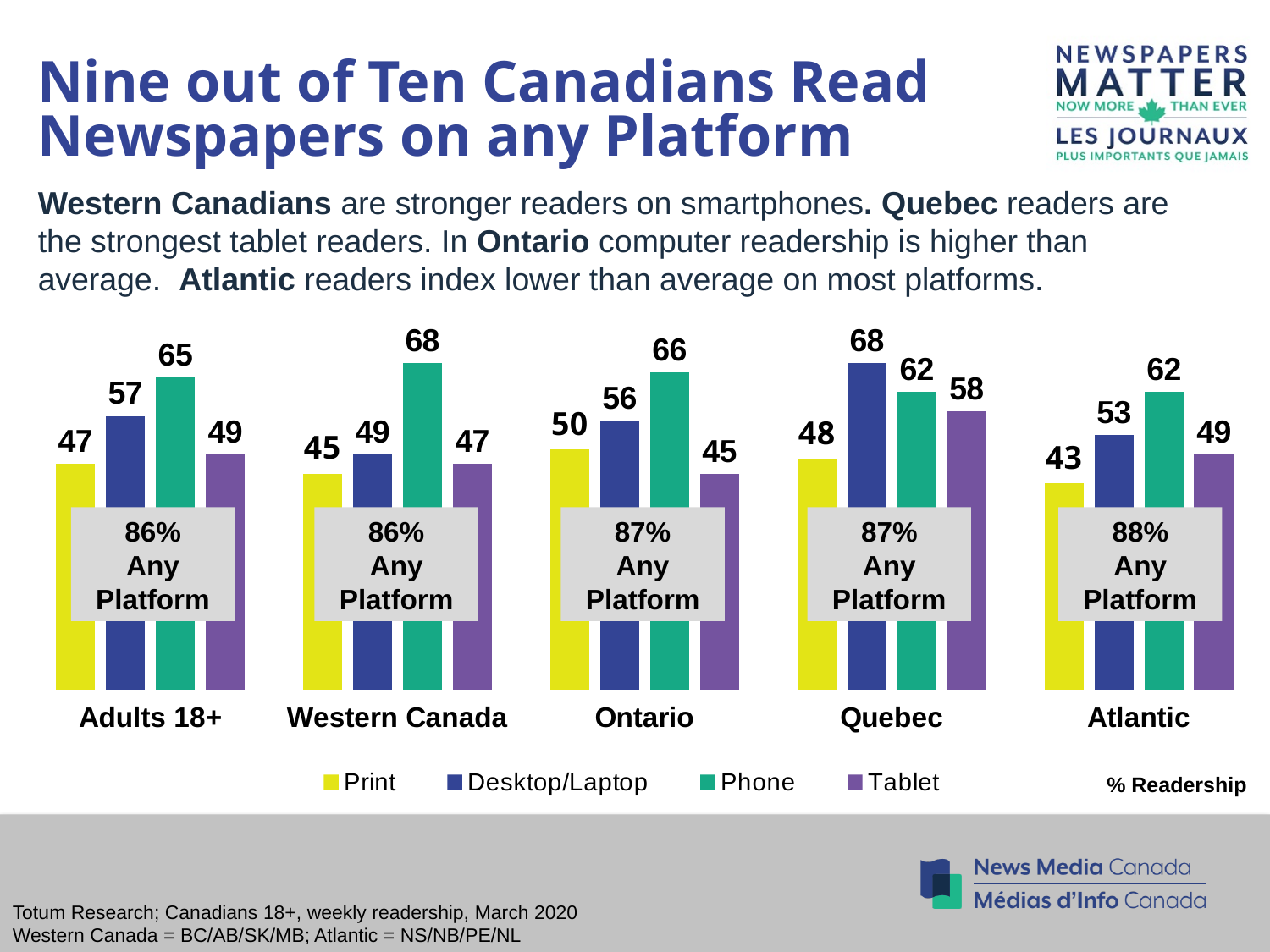
How many series does the legend list? 4 What is the difference between the Phone and Print readership values for Ontario? 16 Which region has the highest Desktop/Laptop readership? Quebec What is the Print readership value for Atlantic? 43 What is the Desktop/Laptop readership value for Adults 18+? 57 How many regions (categories) are shown on the x axis of the chart? 5 Which is larger: the Tablet value for Quebec or the Tablet value for Ontario? Quebec What colour represents the Phone series in the legend? Green What is the Phone readership value for Western Canada? 68 What is the Tablet readership value for Quebec? 58 What kind of chart is shown on the slide? Bar chart Which region has the lowest Print readership? Atlantic